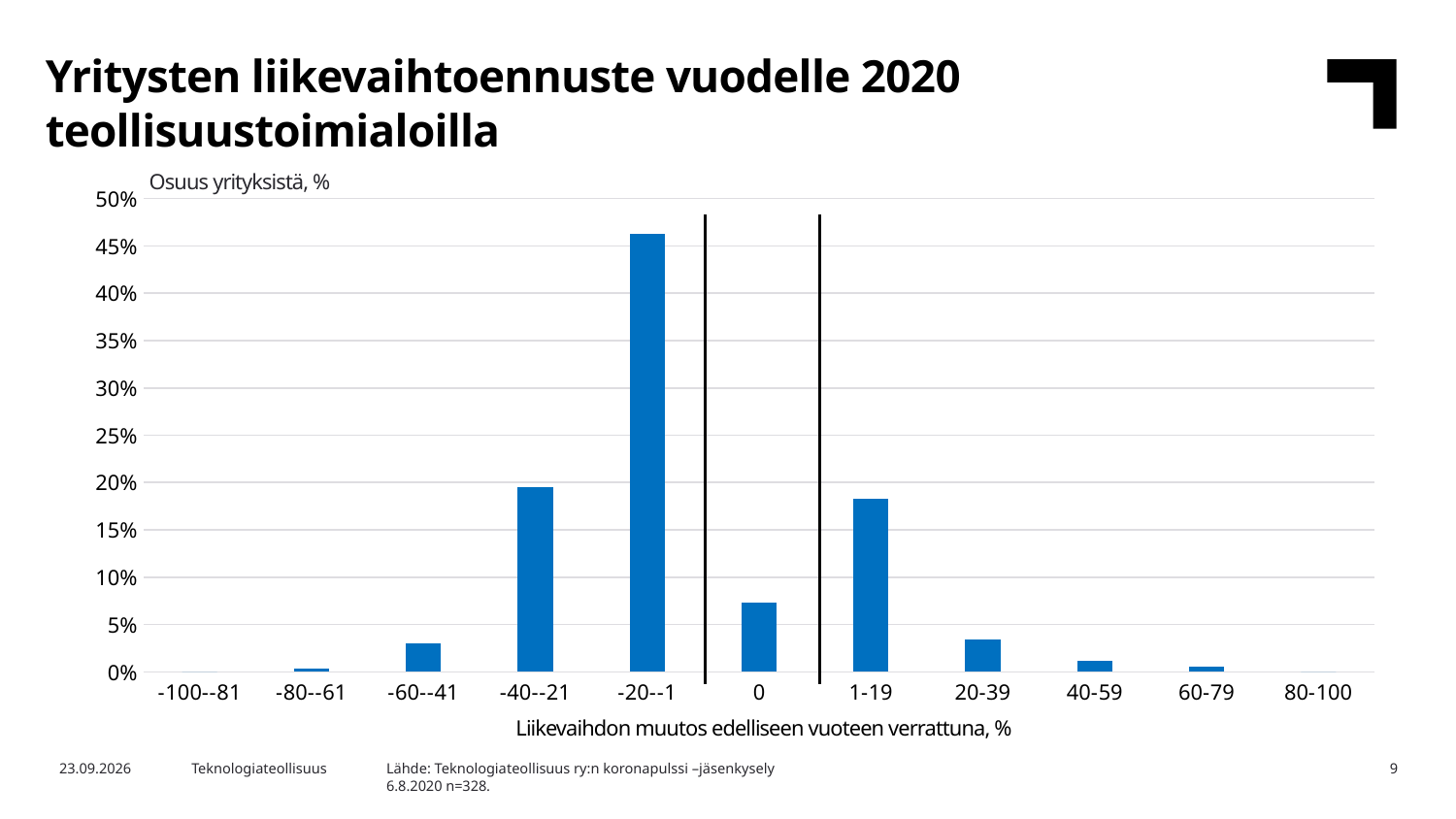
Is the value for 1-19 greater or less than 20%? less Is the value for 0 greater or less than 5%? greater Is the value for -60--41 greater or less than 5%? less Which category has the highest share of companies? -20--1 How many categories are shown on the x axis? 11 Which is larger, the value for -40--21 or the value for 0? -40--21 Which is larger, the value for 20-39 or the value for 60-79? 20-39 What is the label of the x axis? Liikevaihdon muutos edelliseen vuoteen verrattuna, % What kind of chart is shown on the slide? bar chart